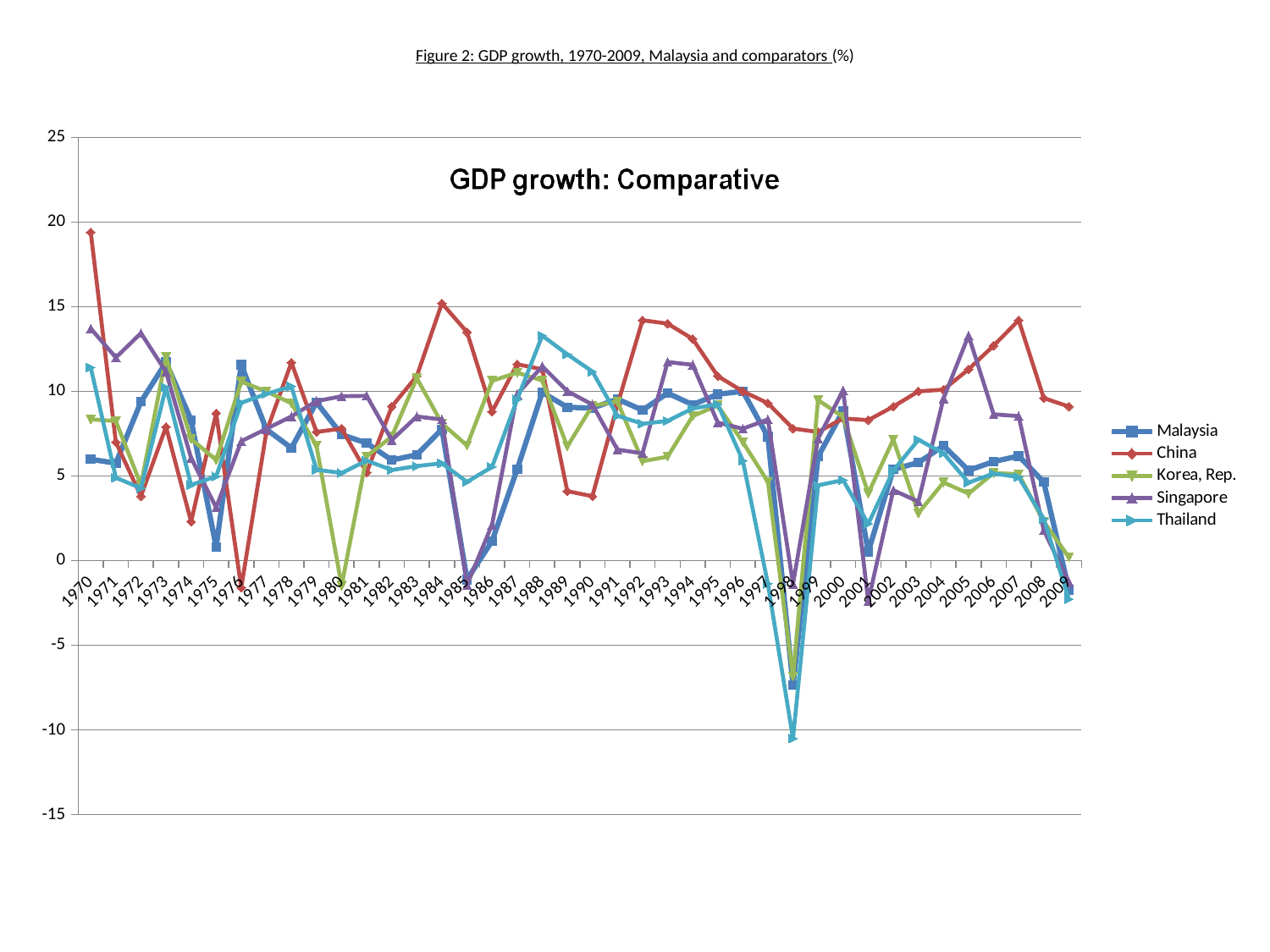
In 1984, which is larger: the value for China or the value for Korea, Rep.? China Which series has the lowest value in 1998? Thailand What is the title shown inside the chart area? GDP growth: Comparative What kind of chart is shown on the slide? line chart Is the value for Singapore in 2005 greater or less than 10? greater Is the value for China in 1970 greater or less than 15? greater Which series has the highest value in 1970? China How many series does the legend list? 5 How many years are plotted along the x axis? 40 Is the value for Malaysia in 1998 greater or less than -5? less Does the value for China rise or fall from 2007 to 2009? fall